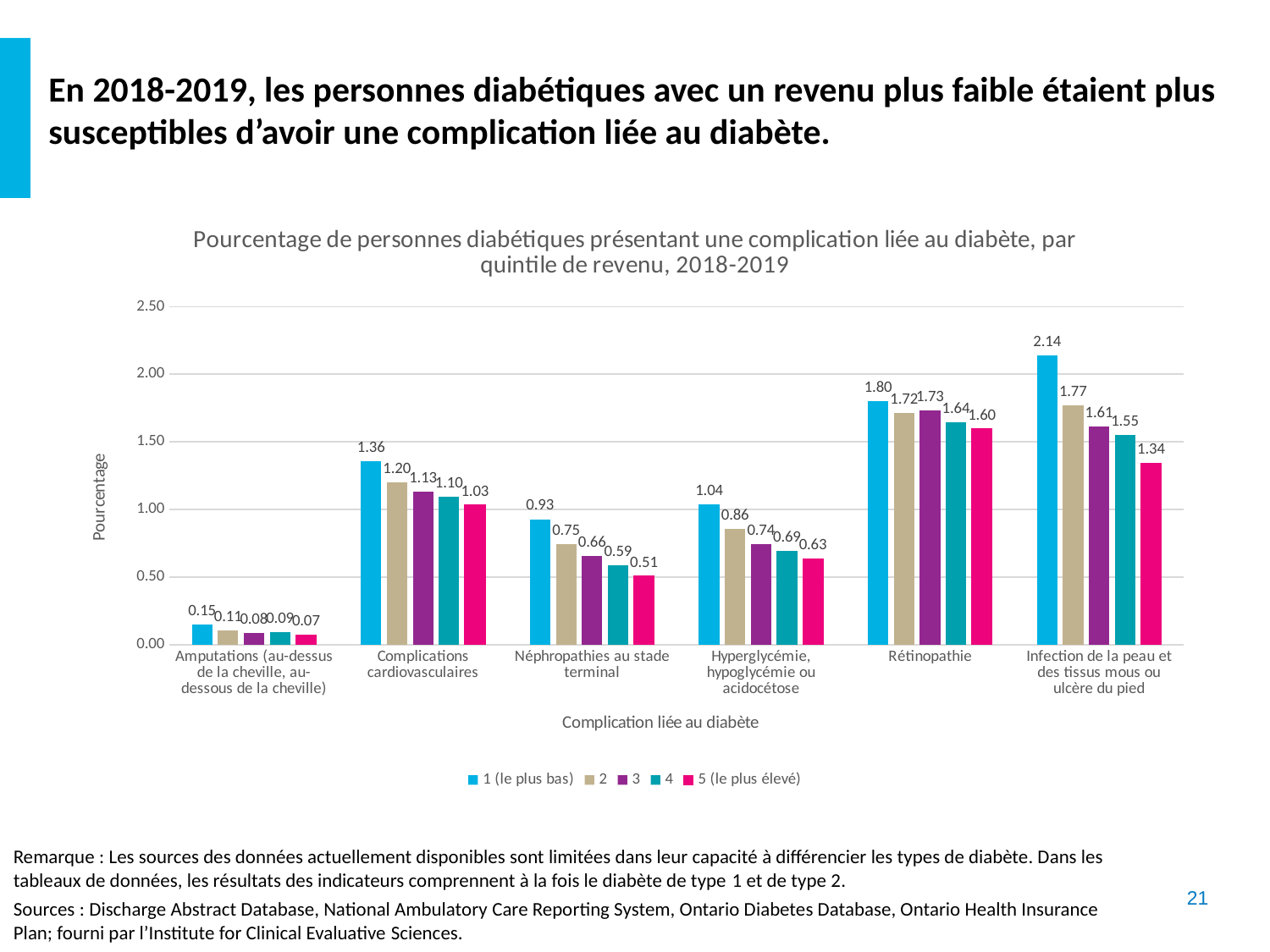
What is the value for quintile 2 for Rétinopathie? 1.72 Which is larger for Hyperglycémie, hypoglycémie ou acidocétose: quintile 1 (le plus bas) or quintile 2? 1 (le plus bas) What is the value for quintile 1 (le plus bas) for Infection de la peau et des tissus mous ou ulcère du pied? 2.14 How many series does the legend list? 5 What is the difference between quintile 1 (le plus bas) and quintile 5 (le plus élevé) for Complications cardiovasculaires? 0.33 What is the value for quintile 5 (le plus élevé) for Néphropathies au stade terminal? 0.51 Is the value for quintile 1 (le plus bas) for Rétinopathie greater or less than 1.50? greater How many complication categories are shown on the x axis? 6 Which complication has the highest value for quintile 1 (le plus bas)? Infection de la peau et des tissus mous ou ulcère du pied What is the label of the y axis? Pourcentage Which complication has the lowest value for quintile 5 (le plus élevé)? Amputations (au-dessus de la cheville, au-dessous de la cheville) What kind of chart is shown on the slide? Bar chart